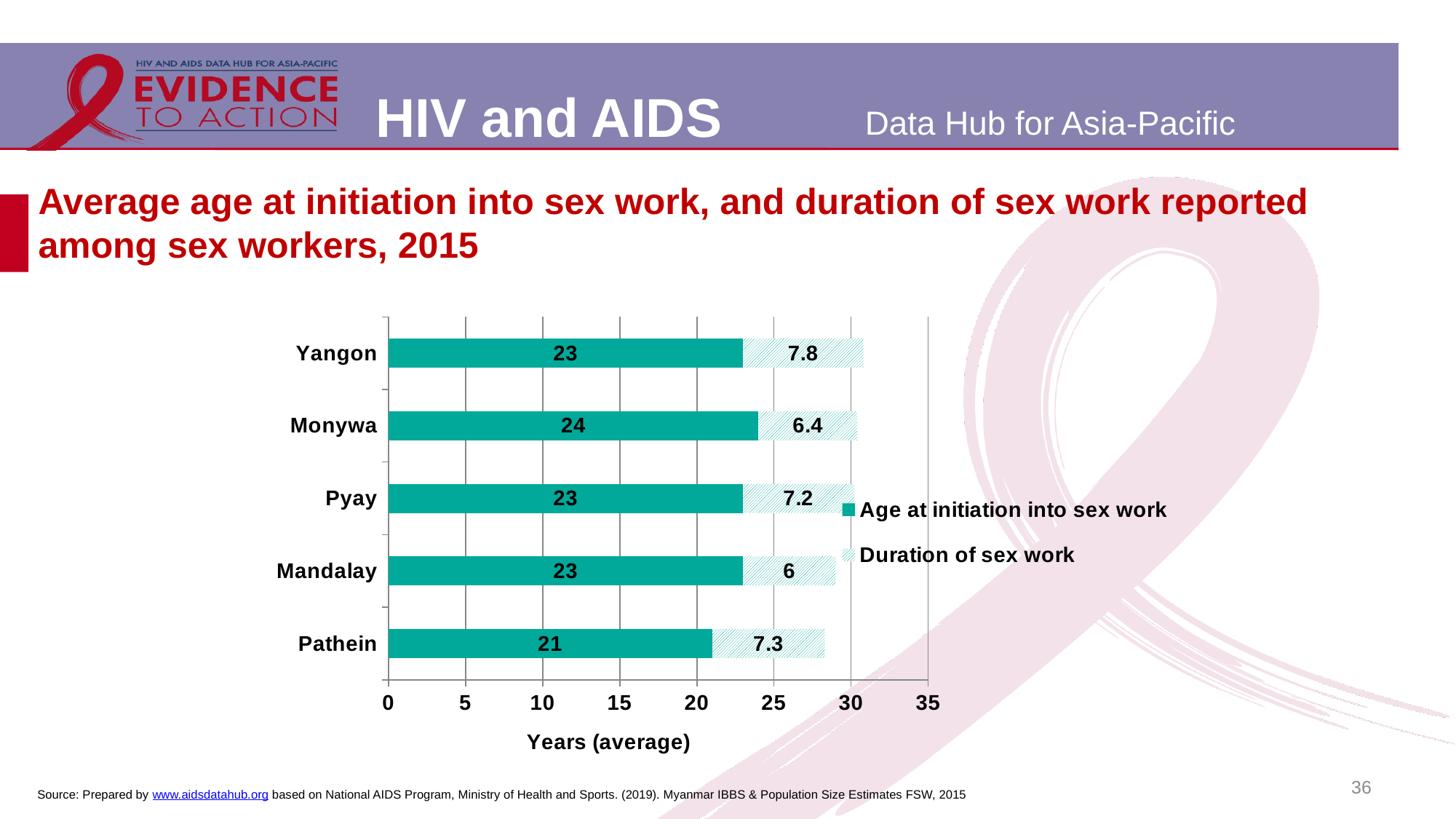
What is the average age at initiation into sex work for Pathein? 21 What is the total length of the stacked bar for Pathein (age at initiation plus duration)? 28.3 What is the duration of sex work reported for Yangon? 7.8 Which location has the lowest average age at initiation into sex work? Pathein What is the difference between the duration of sex work in Yangon and in Mandalay? 1.8 What is the average age at initiation into sex work for Monywa? 24 Which location has the highest duration of sex work? Yangon What type of chart is shown on the slide? Stacked bar chart Which location has the lowest duration of sex work? Mandalay Is the duration of sex work longer in Pyay or in Monywa? Pyay How many locations are shown in the chart? 5 How many series does the legend list? 2